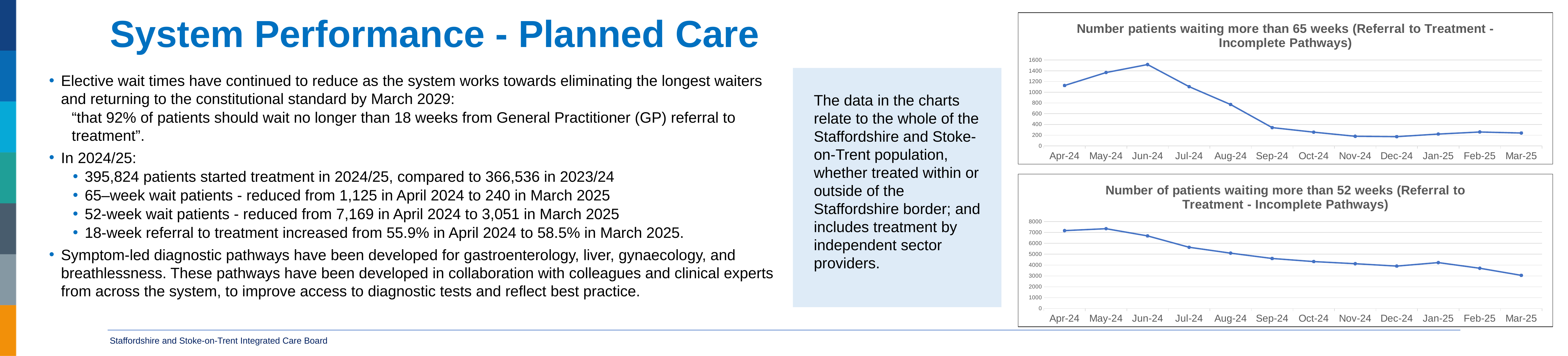
In the 'Number patients waiting more than 65 weeks' chart, which month has the highest value? Jun-24 What kind of chart is the 'Number patients waiting more than 65 weeks' chart? line chart In the 'Number of patients waiting more than 52 weeks' chart, which month has the lowest value? Mar-25 In the 'Number of patients waiting more than 52 weeks' chart, which is larger, the value for Jun-24 or the value for Nov-24? Jun-24 What is the first month shown on the x axis of the 'Number of patients waiting more than 52 weeks' chart? Apr-24 In the 'Number patients waiting more than 65 weeks' chart, is the value for Apr-24 greater or less than 1000? greater How many months are plotted in the 'Number patients waiting more than 65 weeks' chart? 12 In the 'Number of patients waiting more than 52 weeks' chart, is the value for Apr-24 greater or less than 6000? greater In the 'Number of patients waiting more than 52 weeks' chart, do the values generally rise or fall from Apr-24 to Mar-25? fall In the 'Number of patients waiting more than 52 weeks' chart, is the value for Mar-25 greater or less than 4000? less In the 'Number patients waiting more than 65 weeks' chart, which is larger, the value for Jun-24 or the value for Mar-25? Jun-24